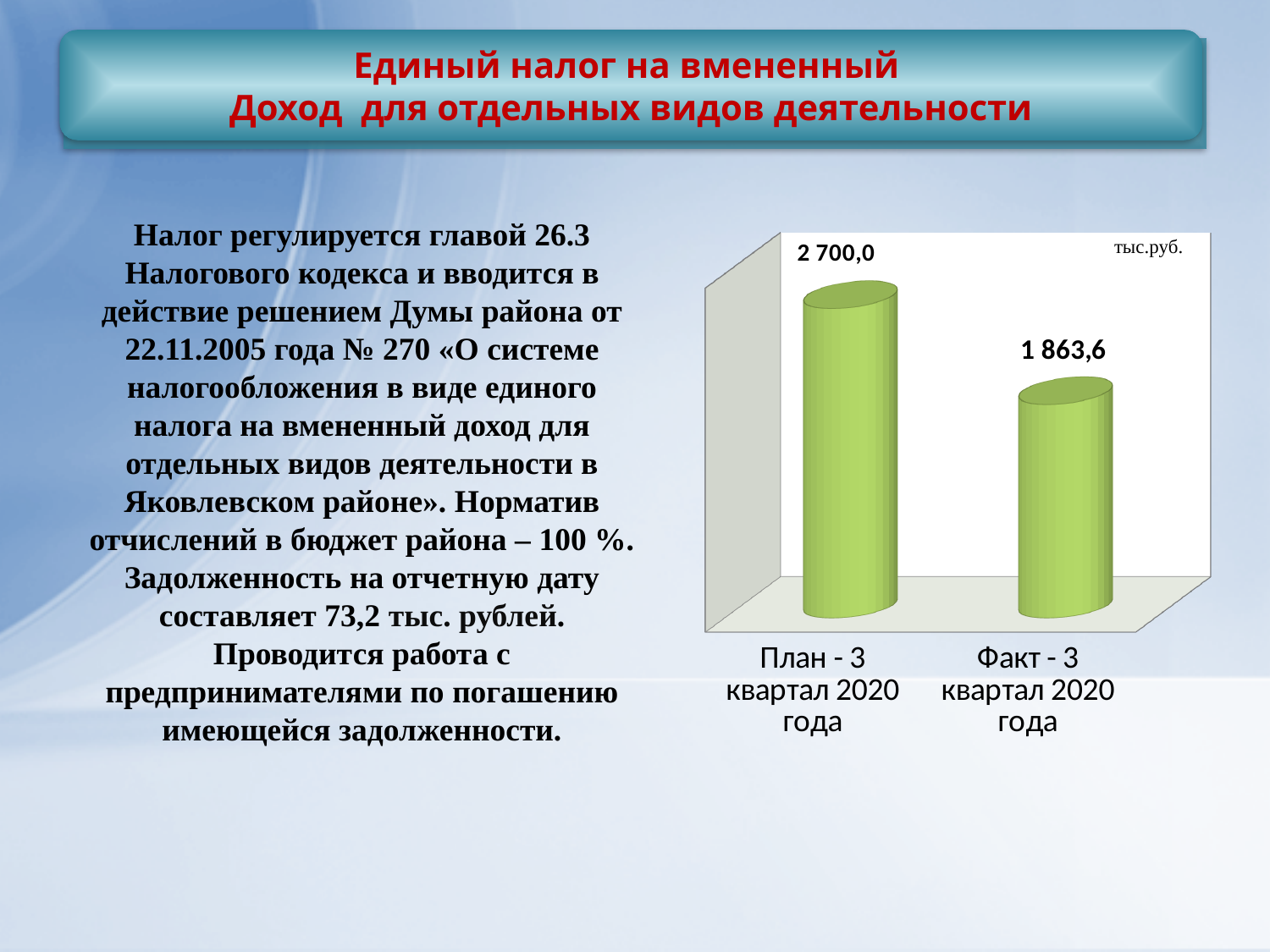
Which category has the lowest value? Факт - 3 квартал 2020 года What kind of chart is shown on the slide? bar chart Do the values rise or fall from the План bar to the Факт bar? fall How many categories are shown in the chart? 2 Which category has the highest value? План - 3 квартал 2020 года What is the value for План - 3 квартал 2020 года? 2 700,0 What colour are the bars in the chart? green What is the value for Факт - 3 квартал 2020 года? 1 863,6 What unit is indicated in the top right corner of the chart? тыс.руб. Which is larger, the План value or the Факт value for 3 квартал 2020 года? План - 3 квартал 2020 года What is the difference between the План and Факт values for 3 квартал 2020 года? 836,4